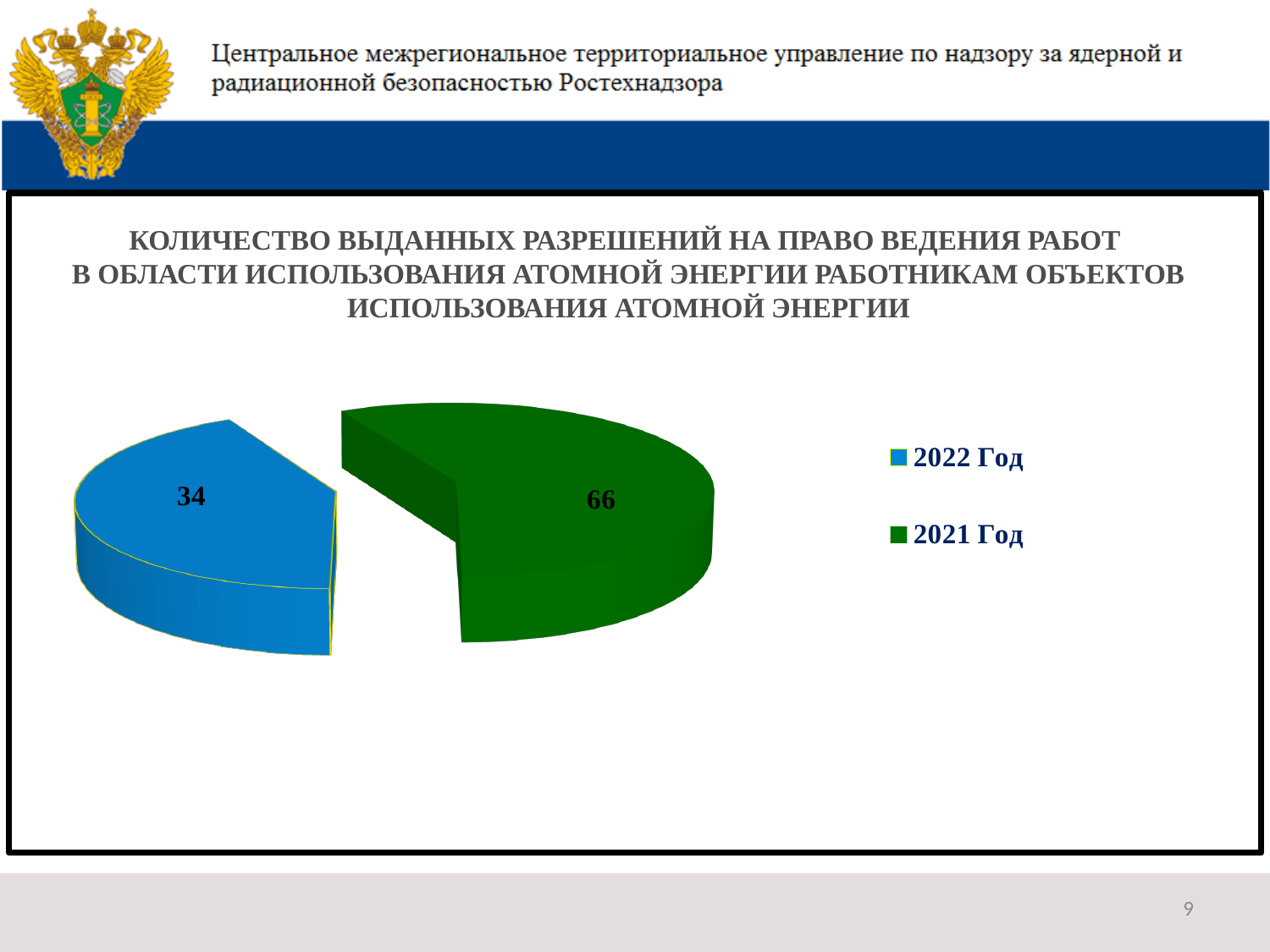
Which year has the larger slice of the pie? 2021 Год Which year has the smaller slice of the pie? 2022 Год What kind of chart is shown on the slide? pie chart How many entries does the legend list? 2 What colour is the slice for 2022 Год? blue What is the total of the two slices in the pie chart? 100 How many slices does the pie chart have? 2 What is the value for 2021 Год? 66 What is the value for 2022 Год? 34 What is the difference between the values for 2021 Год and 2022 Год? 32 Is the value for 2021 Год larger or smaller than the value for 2022 Год? larger